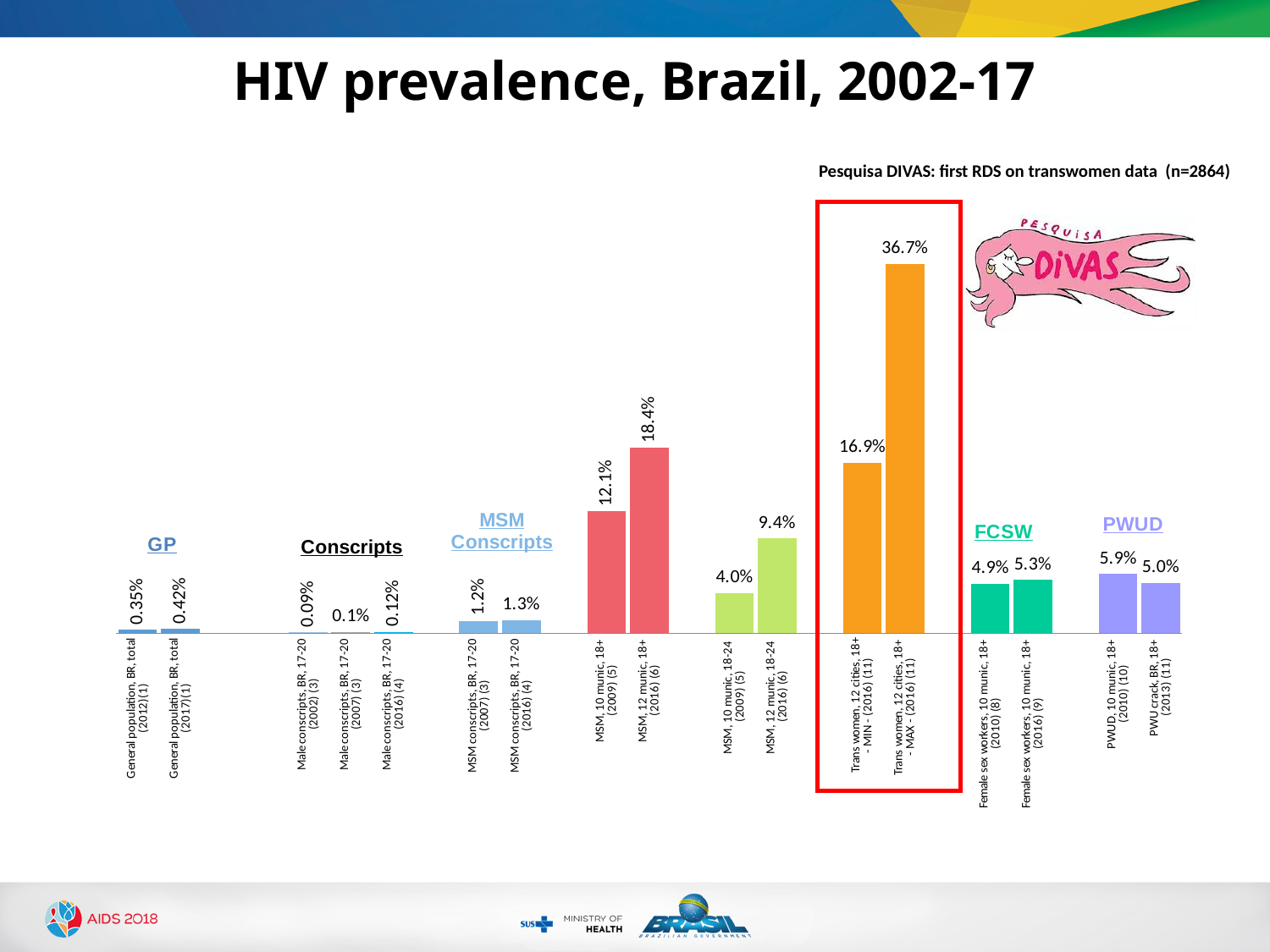
Which bar has the lowest HIV prevalence on the chart? Male conscripts, BR, 17-20 (2002) How many bars are plotted on the chart? 17 What is the HIV prevalence shown for Trans women, 12 cities, 18+ - MAX - (2016)? 36.7% What is the HIV prevalence shown for Female sex workers, 10 munic, 18+ (2010)? 4.9% What is the difference in HIV prevalence between MSM, 12 munic, 18+ (2016) and MSM, 10 munic, 18+ (2009)? 6.3% What is the HIV prevalence shown for MSM, 12 munic, 18+ (2016)? 18.4% What type of chart is shown on the slide? Bar chart What is the HIV prevalence shown for General population, BR, total (2017)? 0.42% Which bar has the highest HIV prevalence on the chart? Trans women, 12 cities, 18+ - MAX - (2016) What is the title of the chart on the slide? HIV prevalence, Brazil, 2002-17 Which is larger: the HIV prevalence for PWUD, 10 munic, 18+ (2010) or for PWU crack, BR, 18+ (2013)? PWUD, 10 munic, 18+ (2010) What is the difference between the MAX and MIN HIV prevalence values for Trans women, 12 cities, 18+ (2016)? 19.8%